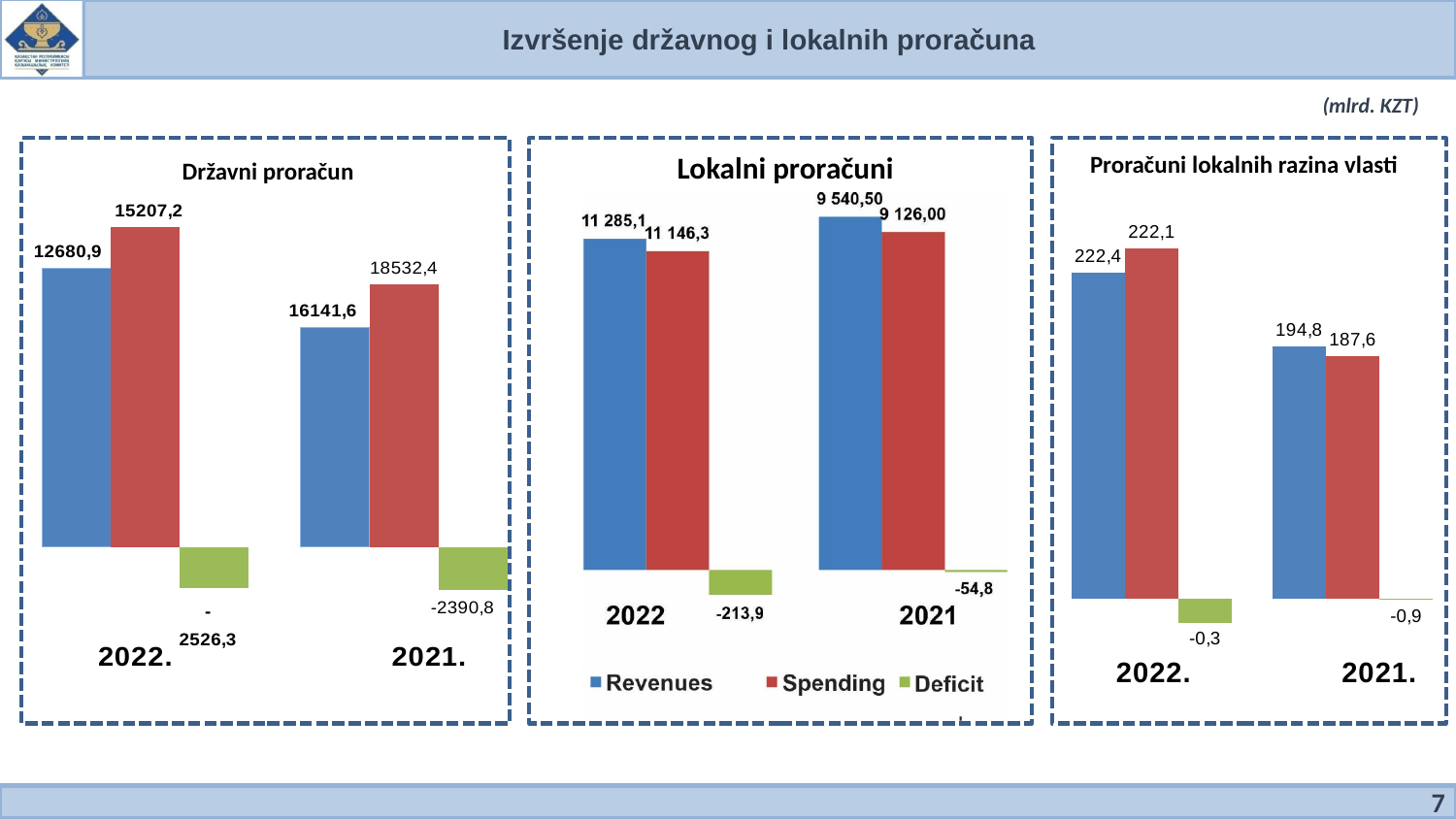
In the 'Državni proračun' chart, what is the value of the blue (revenues) bar for 2021? 16141,6 In the 'Lokalni proračuni' chart, which is larger for 2021: Revenues or Spending? Revenues In the 'Državni proračun' chart, what is the deficit value shown for 2021? -2390,8 In the 'Državni proračun' chart, how many years are shown on the x axis? 2 In the 'Državni proračun' chart, what is the value of the red (spending) bar for 2022? 15207,2 What type of chart is the 'Lokalni proračuni' chart? Bar chart In the 'Proračuni lokalnih razina vlasti' chart, what is the value of the red bar for 2021? 187,6 What unit is stated for the values on the slide? mlrd. KZT In the 'Lokalni proračuni' chart, what is the Deficit value for 2021? -54,8 In the 'Proračuni lokalnih razina vlasti' chart, what is the difference between the blue bar (222,4) and the red bar (222,1) for 2022? 0,3 In the 'Lokalni proračuni' chart, what is the Revenues value for 2022? 11 285,1 In the 'Lokalni proračuni' chart, how many series does the legend list? 3